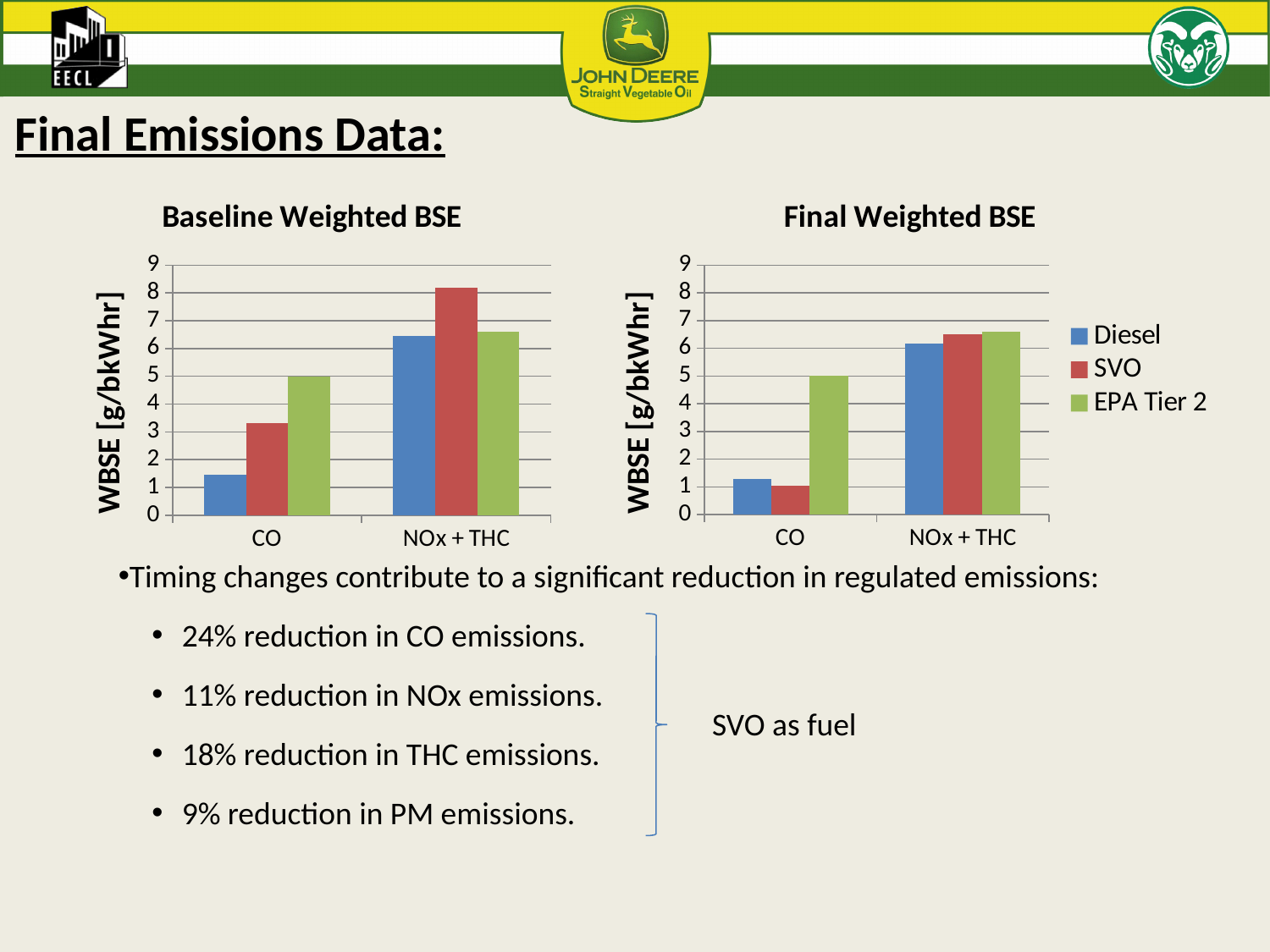
How many categories are shown on the x axis of the Final Weighted BSE chart? 2 What is the y-axis label on the Final Weighted BSE chart? WBSE [g/bkWhr] In the Baseline Weighted BSE chart, which is larger for CO: the SVO value or the Diesel value? SVO How many series does the legend on the Final Weighted BSE chart list? 3 In the Baseline Weighted BSE chart, which series has the highest value for CO? EPA Tier 2 In the Baseline Weighted BSE chart, which series has the lowest value for CO? Diesel In the Baseline Weighted BSE chart, which series has the highest value for NOx + THC? SVO What kind of chart is the Baseline Weighted BSE chart? bar chart In the Final Weighted BSE chart, which series has the highest value for CO? EPA Tier 2 In the Final Weighted BSE chart, is the Diesel value for NOx + THC greater or less than 5? greater In the Baseline Weighted BSE chart, is the SVO value for NOx + THC greater or less than 7? greater In the Baseline Weighted BSE chart, is the Diesel value for CO greater or less than 2? less